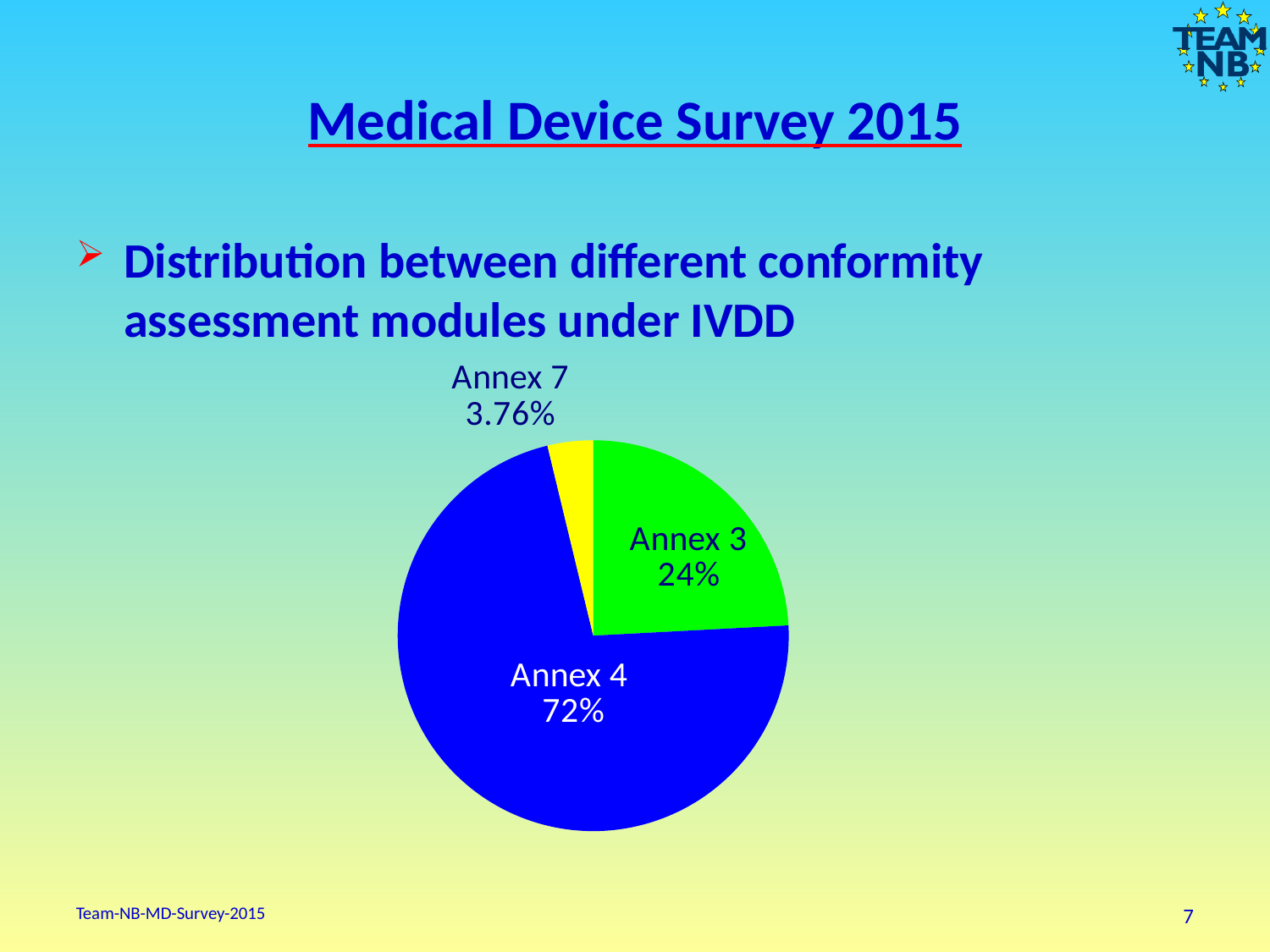
Which annex has the largest slice of the pie? Annex 4 What share of the pie does Annex 7 represent? 3.76% What is the difference in percentage points between the Annex 4 share and the Annex 3 share? 48 What share of the pie does Annex 4 represent? 72% Which annex has the smallest slice of the pie? Annex 7 What share of the pie does Annex 3 represent? 24% What kind of chart is shown on the slide? pie chart What colour is the Annex 7 slice? yellow Which is larger, the share for Annex 3 or the share for Annex 7? Annex 3 How many slices does the pie chart have? 3 What colour is the Annex 4 slice? blue